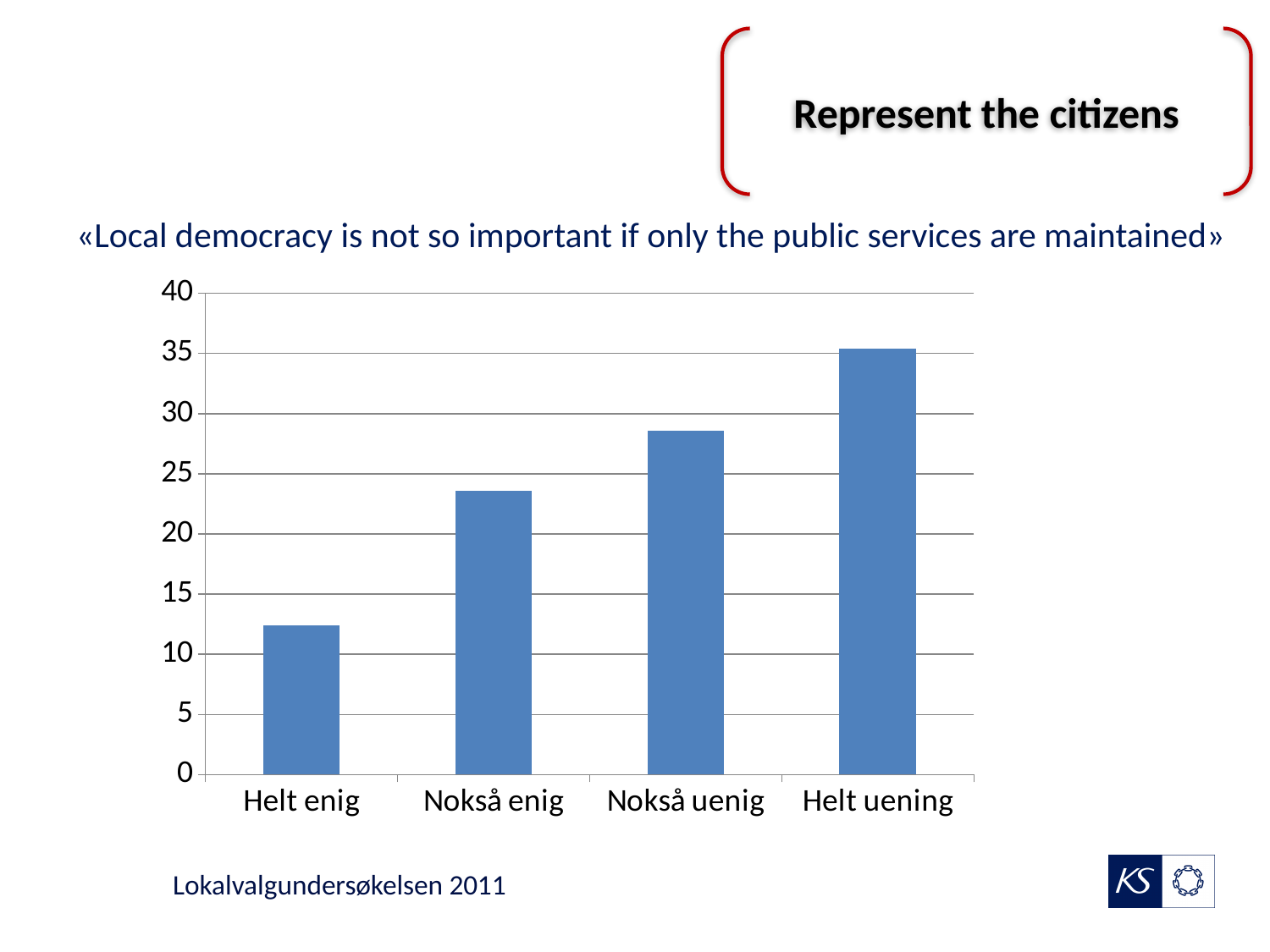
Is the value for Helt enig greater or less than 15? less What kind of chart is shown on the slide? bar chart Is the value for Nokså uenig greater or less than 25? greater Is the value for Nokså enig greater or less than 25? less What statement is the chart about, as quoted above it? «Local democracy is not so important if only the public services are maintained» How many categories are shown on the x axis of the chart? 4 Which is larger, the value for Nokså enig or the value for Nokså uenig? Nokså uenig Which category has the highest bar? Helt uening Do the bar values rise or fall from left to right along the x axis? rise Which category has the lowest bar? Helt enig